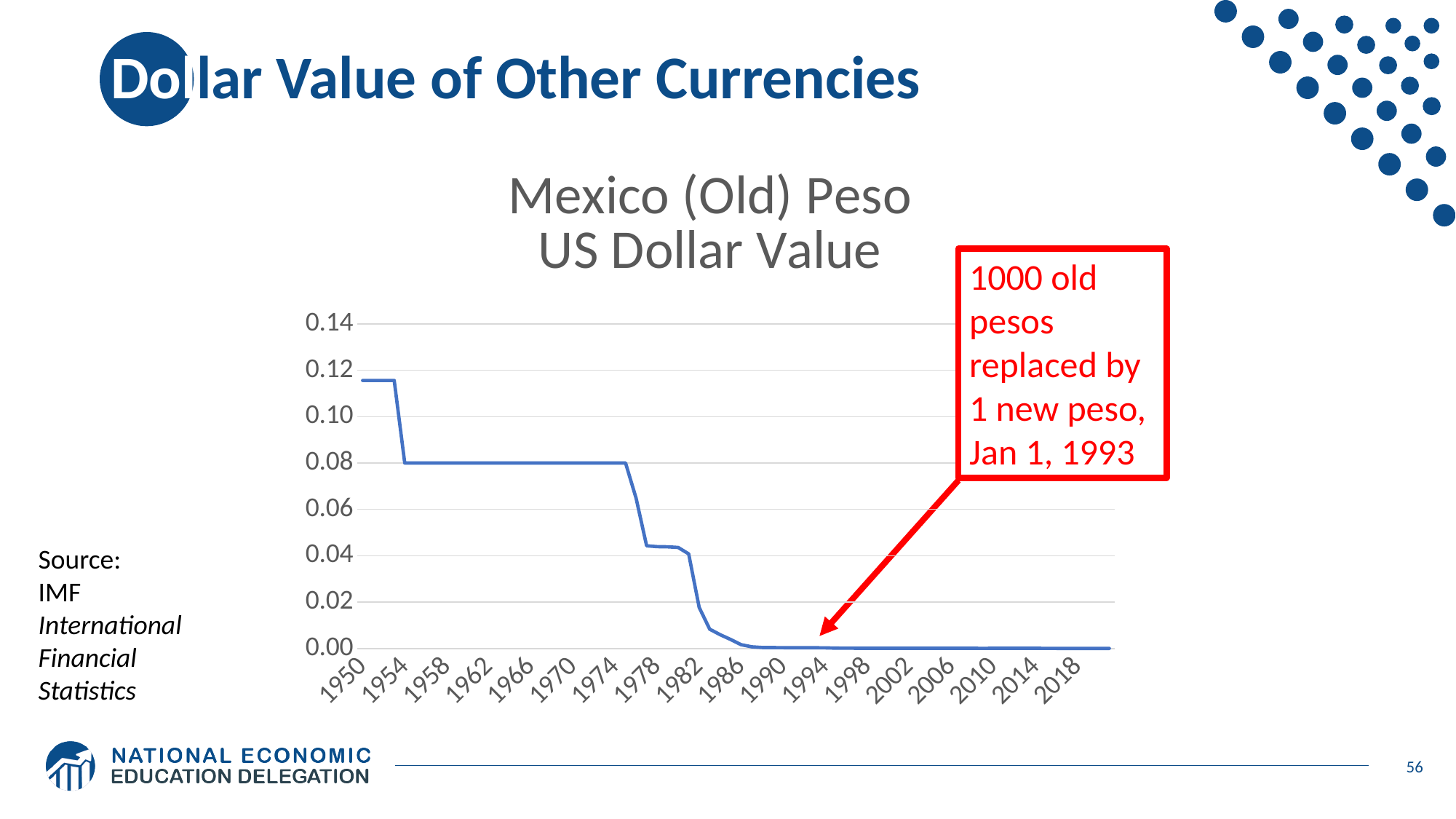
Do the values rise or fall along the x axis from 1950 to 2018? fall Is the value for 1950 greater or less than 0.10? greater Which year on the x axis has the highest value? 1950 Is the value for 1970 greater or less than 0.06? greater Is the value for 1978 greater or less than 0.06? less What kind of chart is shown on the slide? line chart What is the title of the chart? Mexico (Old) Peso US Dollar Value What does the red annotation box on the chart say? 1000 old pesos replaced by 1 new peso, Jan 1, 1993 Which is larger, the value for 1954 or the value for 1986? 1954 How many year labels are shown on the x axis? 18